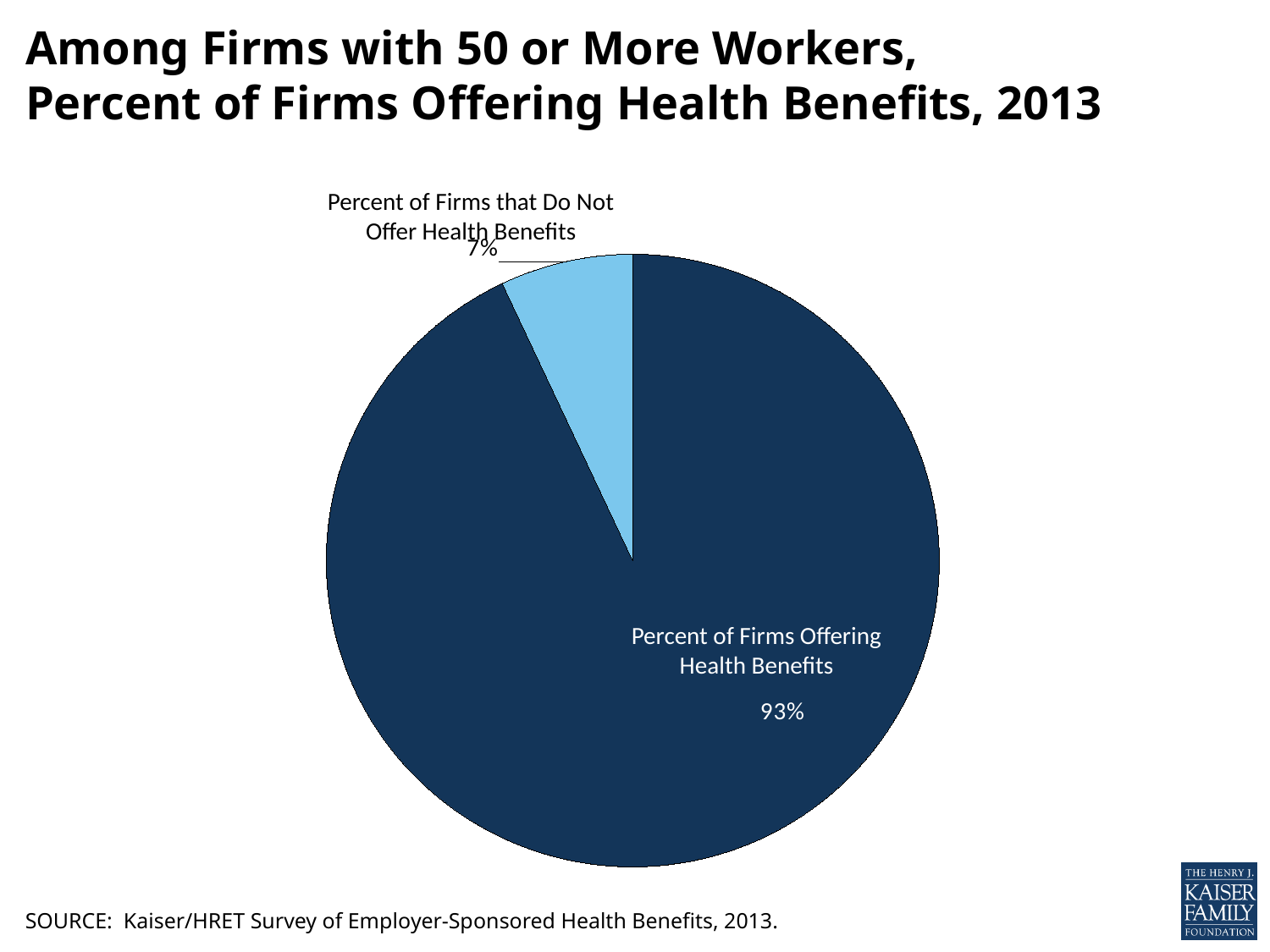
What kind of chart is shown on the slide? Pie chart Which slice of the pie is the largest? Percent of Firms Offering Health Benefits What percent of firms with 50 or more workers do not offer health benefits? 7% What colour is the slice for firms that do not offer health benefits? Light blue Which slice of the pie is the smallest? Percent of Firms that Do Not Offer Health Benefits What is the difference in percentage points between firms offering and firms not offering health benefits? 86 What is the title of the chart? Among Firms with 50 or More Workers, Percent of Firms Offering Health Benefits, 2013 What percent of firms with 50 or more workers offer health benefits? 93% Which is larger: the share of firms offering health benefits or the share not offering them? Percent of Firms Offering Health Benefits What year does the chart's data refer to? 2013 What share of the pie does the 'Percent of Firms that Do Not Offer Health Benefits' slice represent? 7% How many slices does the pie chart have? 2